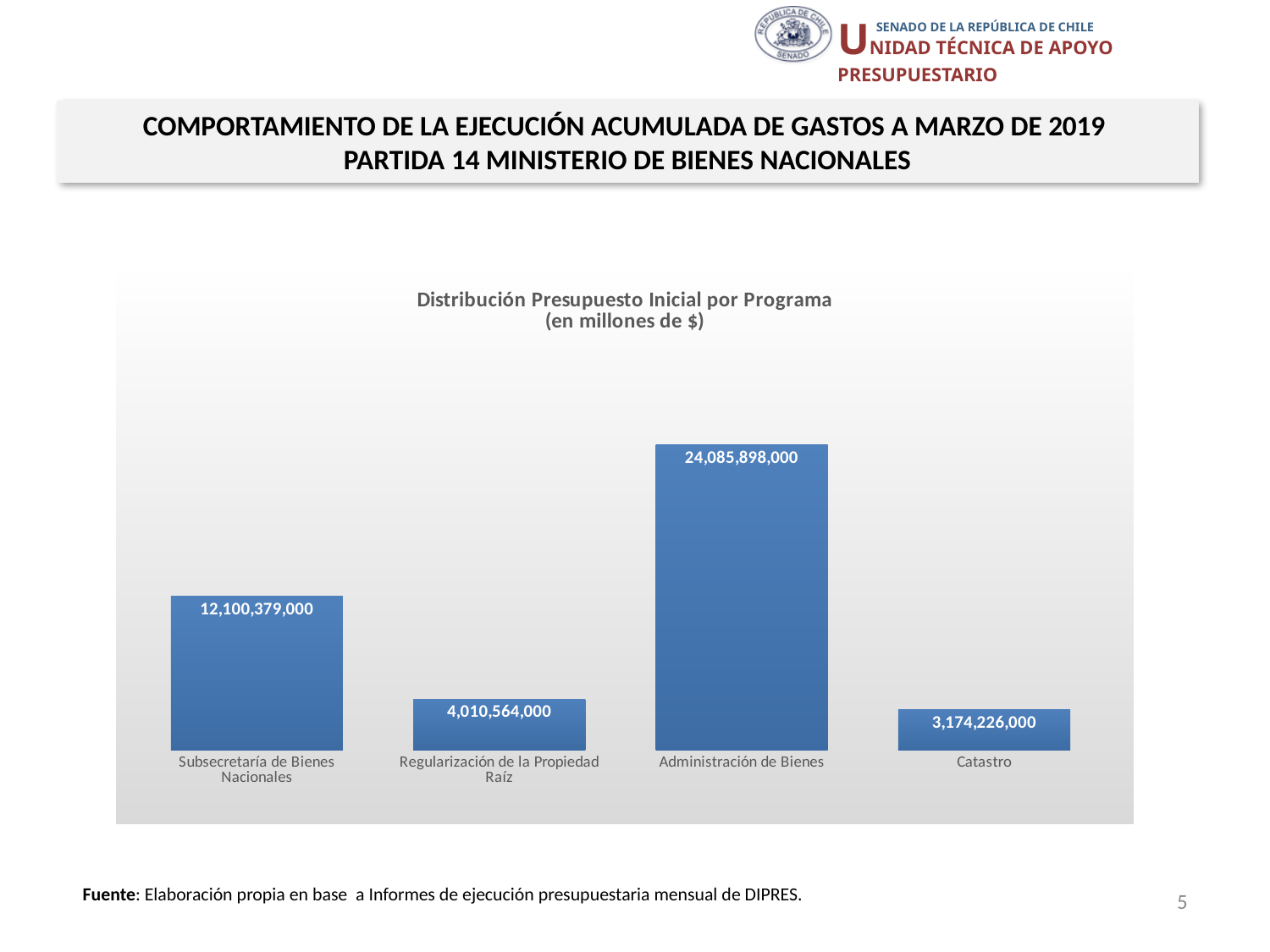
What is the difference between the values for Administración de Bienes and Subsecretaría de Bienes Nacionales? 11,985,519,000 What kind of chart is shown on the slide? Bar chart Which program has the lowest value? Catastro Which program has the highest value? Administración de Bienes What is the value for Subsecretaría de Bienes Nacionales? 12,100,379,000 What is the difference between the values for Regularización de la Propiedad Raíz and Catastro? 836,338,000 What is the value for Administración de Bienes? 24,085,898,000 What is the title of the chart? Distribución Presupuesto Inicial por Programa (en millones de $) How many programs are shown in the chart? 4 What is the value for Catastro? 3,174,226,000 What is the value for Regularización de la Propiedad Raíz? 4,010,564,000 Which is larger, the value for Subsecretaría de Bienes Nacionales or the value for Regularización de la Propiedad Raíz? Subsecretaría de Bienes Nacionales